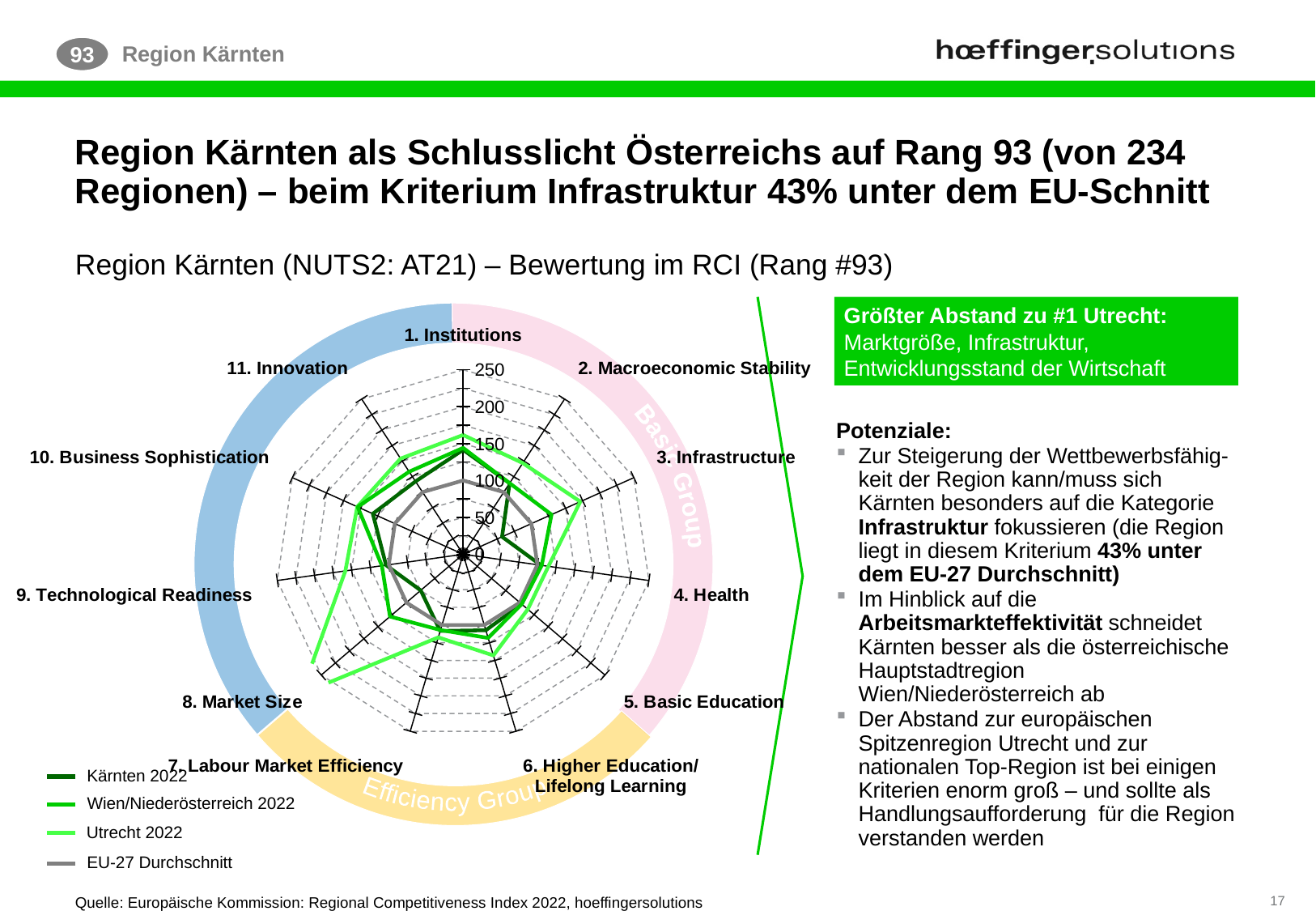
How many categories (axes) does the radar chart have? 11 What kind of chart is shown on the slide? Radar chart Is the value of Utrecht 2022 for 8. Market Size greater or less than 150? greater In which category does Kärnten 2022 have its lowest value? 3. Infrastructure Which series are listed in the legend of the radar chart? Kärnten 2022, Wien/Niederösterreich 2022, Utrecht 2022, EU-27 Durchschnitt How many series does the legend of the radar chart list? 4 Is the value of Kärnten 2022 for 3. Infrastructure greater or less than 100? less For 3. Infrastructure, which is larger: the value for Kärnten 2022 or the value for Utrecht 2022? Utrecht 2022 Which series has the highest value for 8. Market Size? Utrecht 2022 Is the value of Kärnten 2022 for 1. Institutions greater or less than 100? greater What is the highest value shown on the radar chart's axis scale? 250